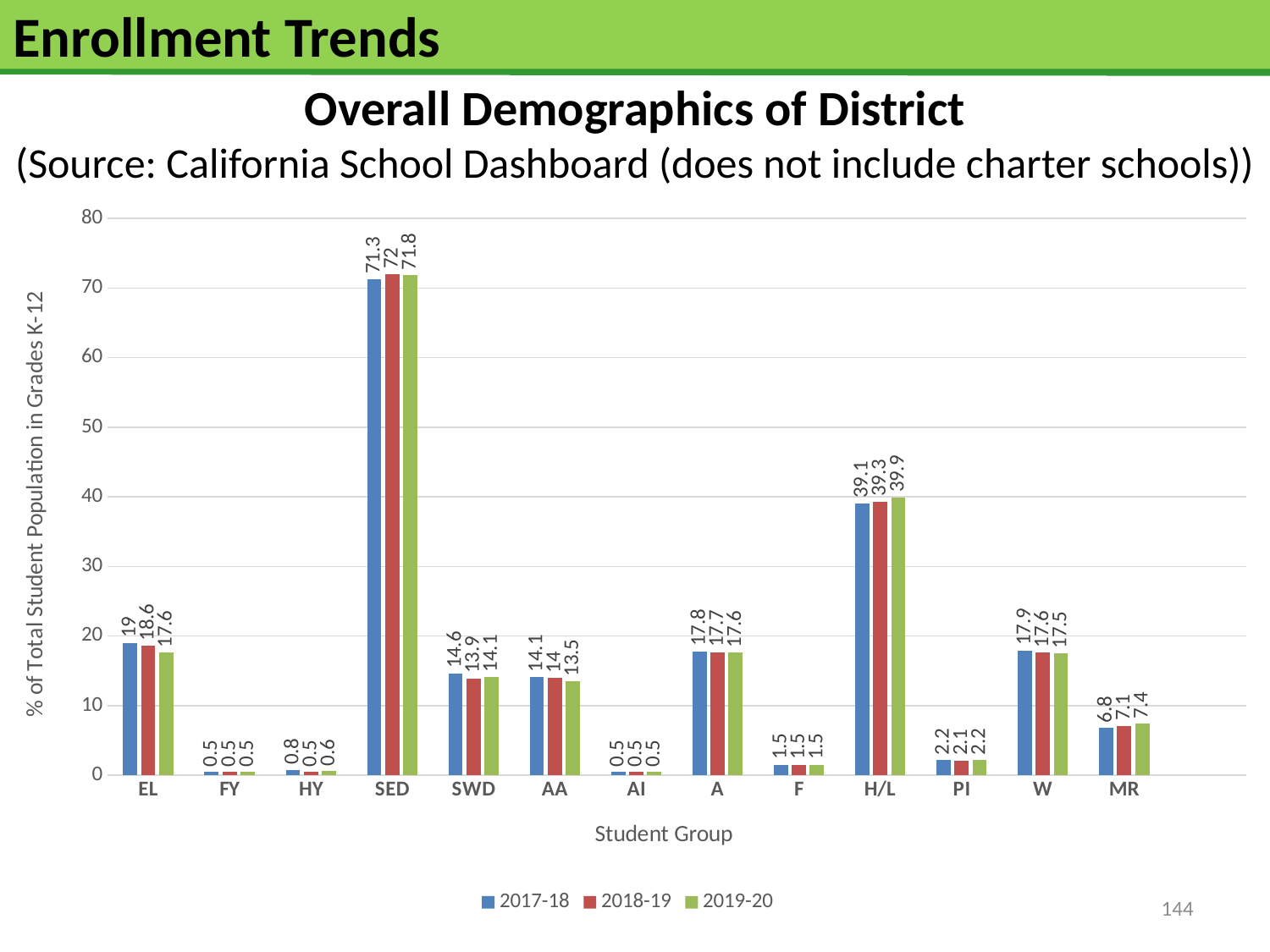
What is the value for MR in 2019-20? 7.4 Which student group has the highest value in 2019-20? SED What is the label of the y axis? % of Total Student Population in Grades K-12 What type of chart is shown on the slide? Bar chart How many series does the legend list? 3 What is the value for EL in 2017-18? 19 What is the difference between the 2017-18 and 2019-20 values for EL? 1.4 What is the value for SED in 2018-19? 72 Do the values for MR rise or fall from 2017-18 to 2019-20? Rise How many student groups are shown on the x axis? 13 Which is larger, the 2017-18 value for SWD or the 2017-18 value for AA? SWD What is the value for H/L in 2019-20? 39.9